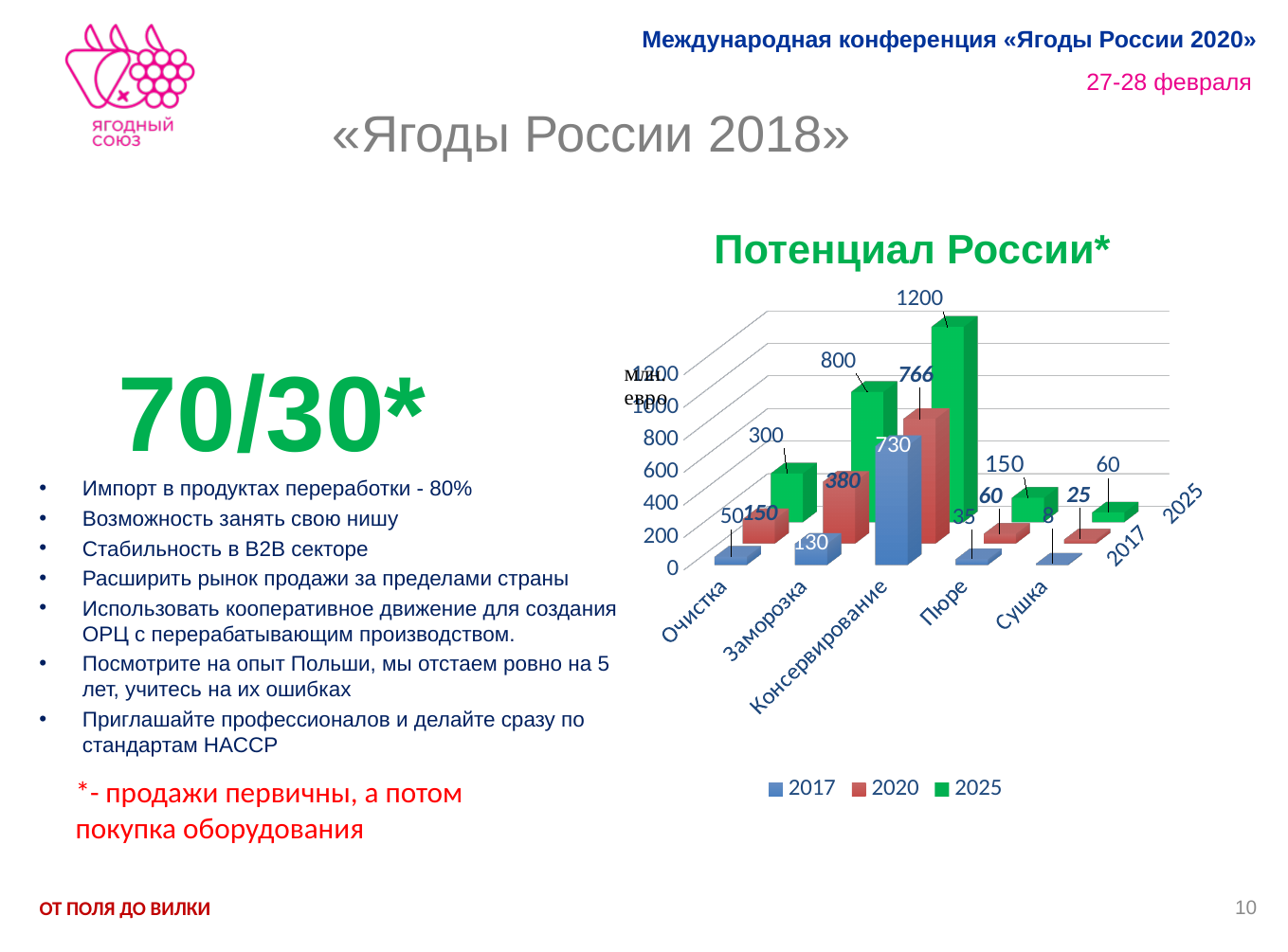
What is the difference between the 2025 and 2017 values for Заморозка? 670 What type of chart is shown under the title «Потенциал России*»? bar chart Which category has the highest value in the 2025 series? Консервирование Which is larger: the 2025 value for Очистка or the 2025 value for Пюре? Очистка What is the value for Заморозка in the 2020 series? 380 What is the value for Консервирование in the 2025 series? 1200 How many series does the legend of the chart list? 3 What is the title of the chart on the slide? Потенциал России* Do the values for Пюре rise or fall from 2017 to 2025? rise How many categories are shown along the x axis of the chart? 5 What is the value for Сушка in the 2017 series? 8 Which category has the lowest value in the 2017 series? Сушка